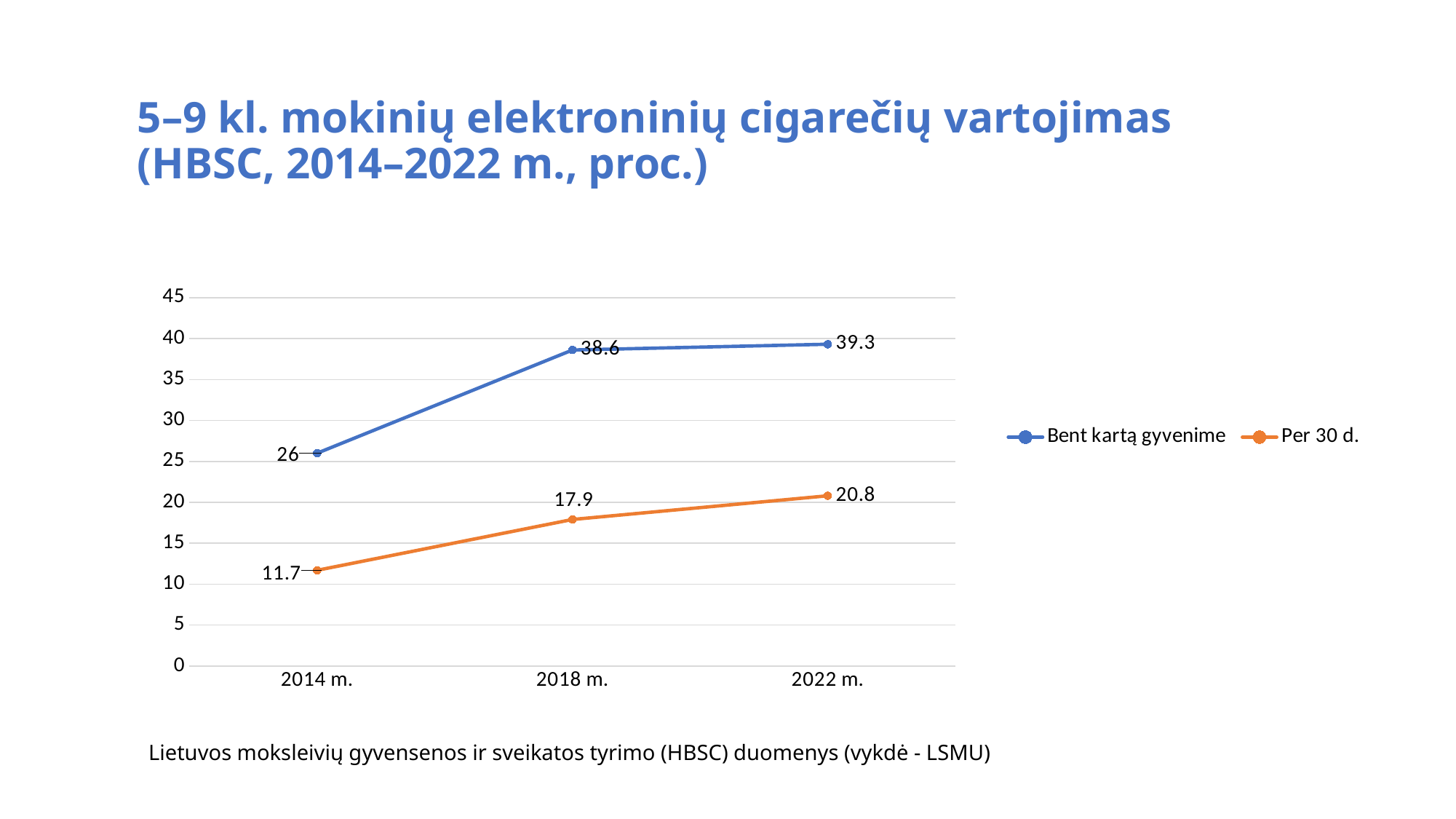
What is the value for "Per 30 d." in 2018 m.? 17.9 What is the difference between the "Bent kartą gyvenime" values in 2018 m. and 2014 m.? 12.6 How many series does the legend list? 2 What is the difference between "Bent kartą gyvenime" and "Per 30 d." in 2022 m.? 18.5 In which year is the "Bent kartą gyvenime" series highest? 2022 m. How many years are shown on the x axis? 3 Which is larger: "Per 30 d." in 2018 m. or "Per 30 d." in 2014 m.? 2018 m. In which year is the "Per 30 d." series lowest? 2014 m. What is the value for "Bent kartą gyvenime" in 2014 m.? 26 What kind of chart is shown on the slide? Line chart What is the value for "Bent kartą gyvenime" in 2022 m.? 39.3 What is the value for "Per 30 d." in 2022 m.? 20.8